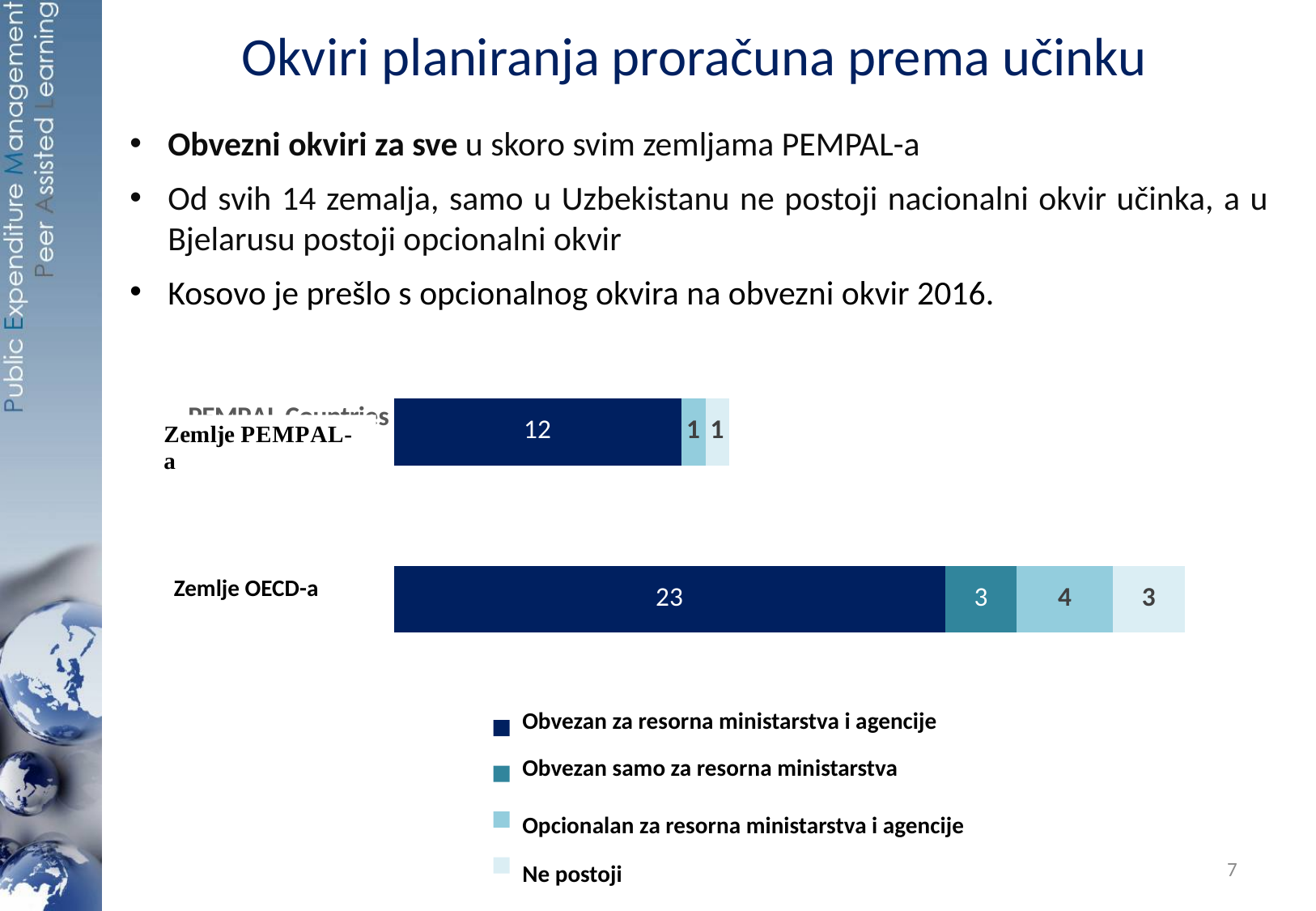
What is the total of the stacked bar for Zemlje OECD-a? 33 What is the total of the stacked bar for Zemlje PEMPAL-a? 14 Which legend entry is represented by the darkest navy colour in the chart? Obvezan za resorna ministarstva i agencije What is the value of 'Obvezan za resorna ministarstva i agencije' for Zemlje PEMPAL-a? 12 How many categories (country groups) are plotted in the chart? 2 What is the value of 'Obvezan samo za resorna ministarstva' for Zemlje OECD-a? 3 What is the value of 'Obvezan za resorna ministarstva i agencije' for Zemlje OECD-a? 23 What kind of chart is shown on the slide? stacked bar chart What is the value of 'Ne postoji' for Zemlje PEMPAL-a? 1 How many series does the chart legend list? 4 What is the difference between the 'Obvezan za resorna ministarstva i agencije' values for Zemlje OECD-a and Zemlje PEMPAL-a? 11 What is the value of 'Opcionalan za resorna ministarstva i agencije' for Zemlje OECD-a? 4